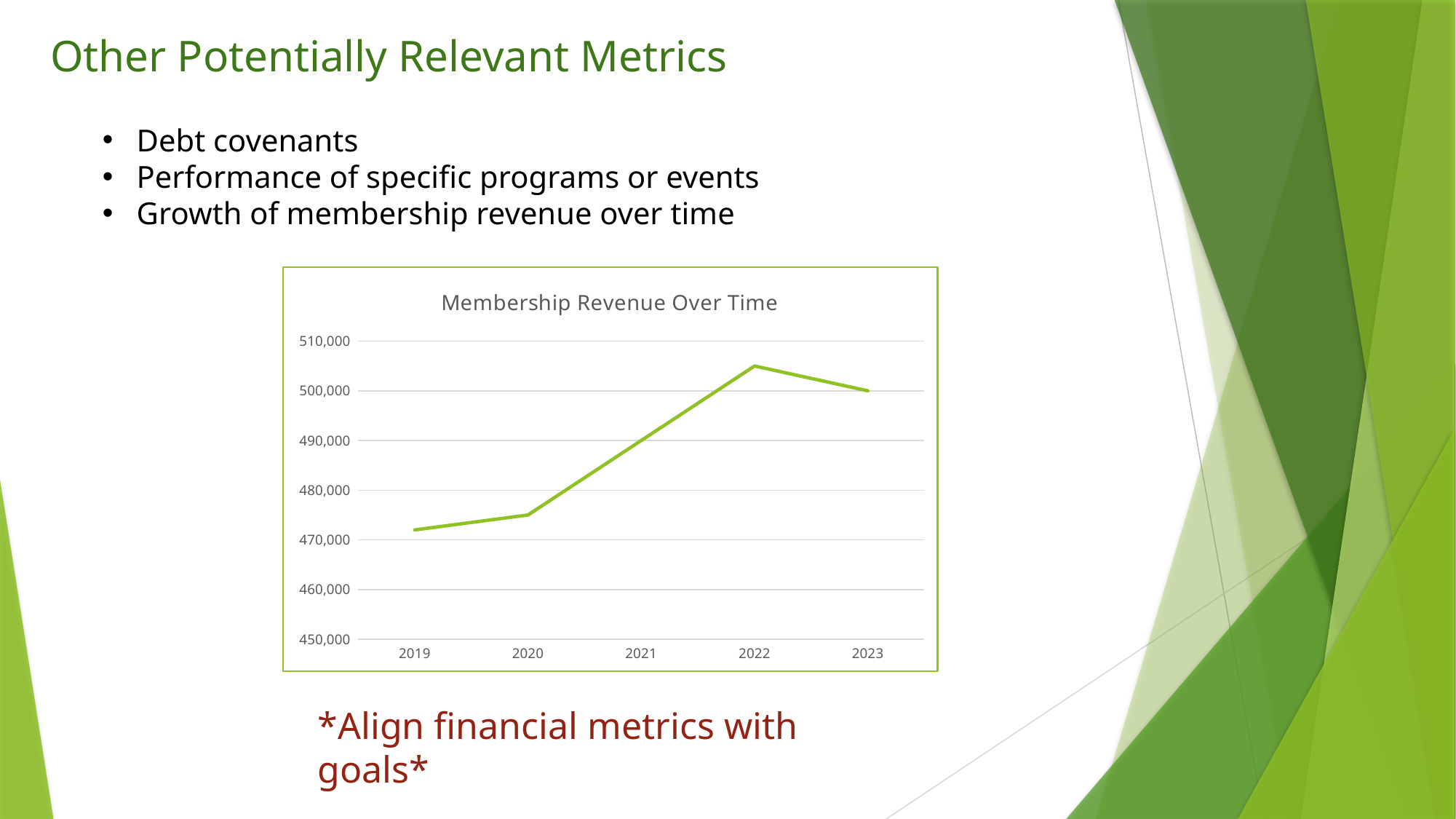
Does membership revenue rise or fall from 2019 to 2022? rise Is the membership revenue for 2019 greater or less than 480,000? less How many years are plotted on the x axis of the chart? 5 Which year has higher membership revenue, 2020 or 2022? 2022 Which year has the highest membership revenue? 2022 Is the membership revenue for 2020 greater or less than 470,000? greater Is the membership revenue for 2022 greater or less than 500,000? greater Which year has the lowest membership revenue? 2019 What is the title of the chart? Membership Revenue Over Time What type of chart is shown on the slide? Line chart Which year has higher membership revenue, 2023 or 2019? 2023